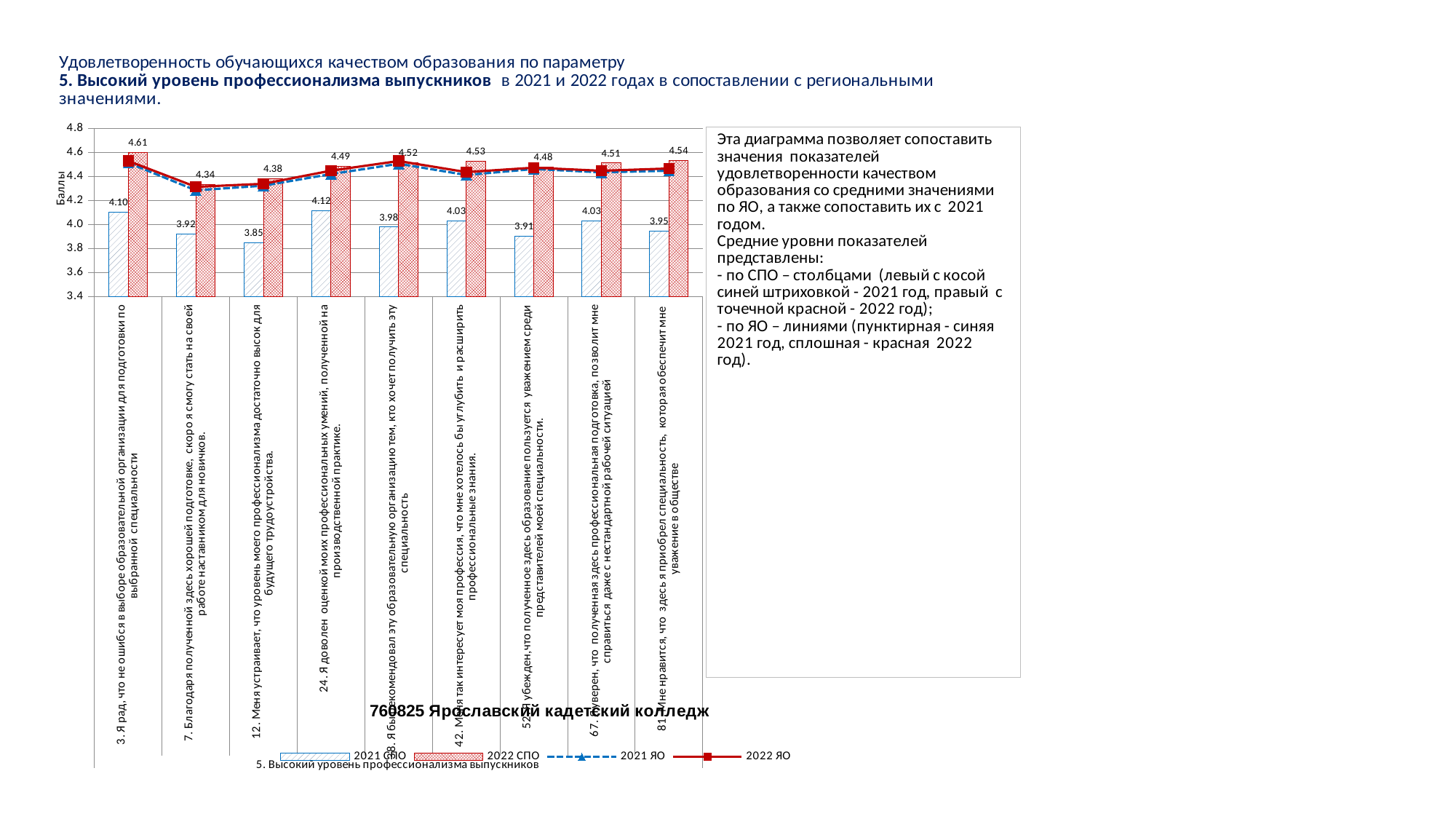
What is the 2022 СПО value for item 81 (Мне нравится, что здесь я приобрел специальность)? 4.54 How many items (categories) are shown on the x axis? 9 Which item has the lowest 2021 СПО value? 12. Меня устраивает, что уровень моего профессионализма достаточно высок (3.85) What is the 2022 СПО value for item 3 (Я рад, что не ошибся в выборе образовательной организации)? 4.61 What is the 2021 СПО value for item 12 (Меня устраивает, что уровень моего профессионализма достаточно высок)? 3.85 For item 3, what is the difference between the 2022 СПО and 2021 СПО values? 0.51 Which has the larger 2021 СПО value: item 24 or item 38? Item 24 (4.12) What is the title of the vertical axis? Баллы Is the 2021 ЯО value for item 3 greater or less than 4.4? greater How many series does the legend list? 4 For item 7, what is the difference between the 2022 СПО and 2021 СПО values? 0.42 Which item has the highest 2022 СПО value? 3. Я рад, что не ошибся в выборе образовательной организации (4.61)